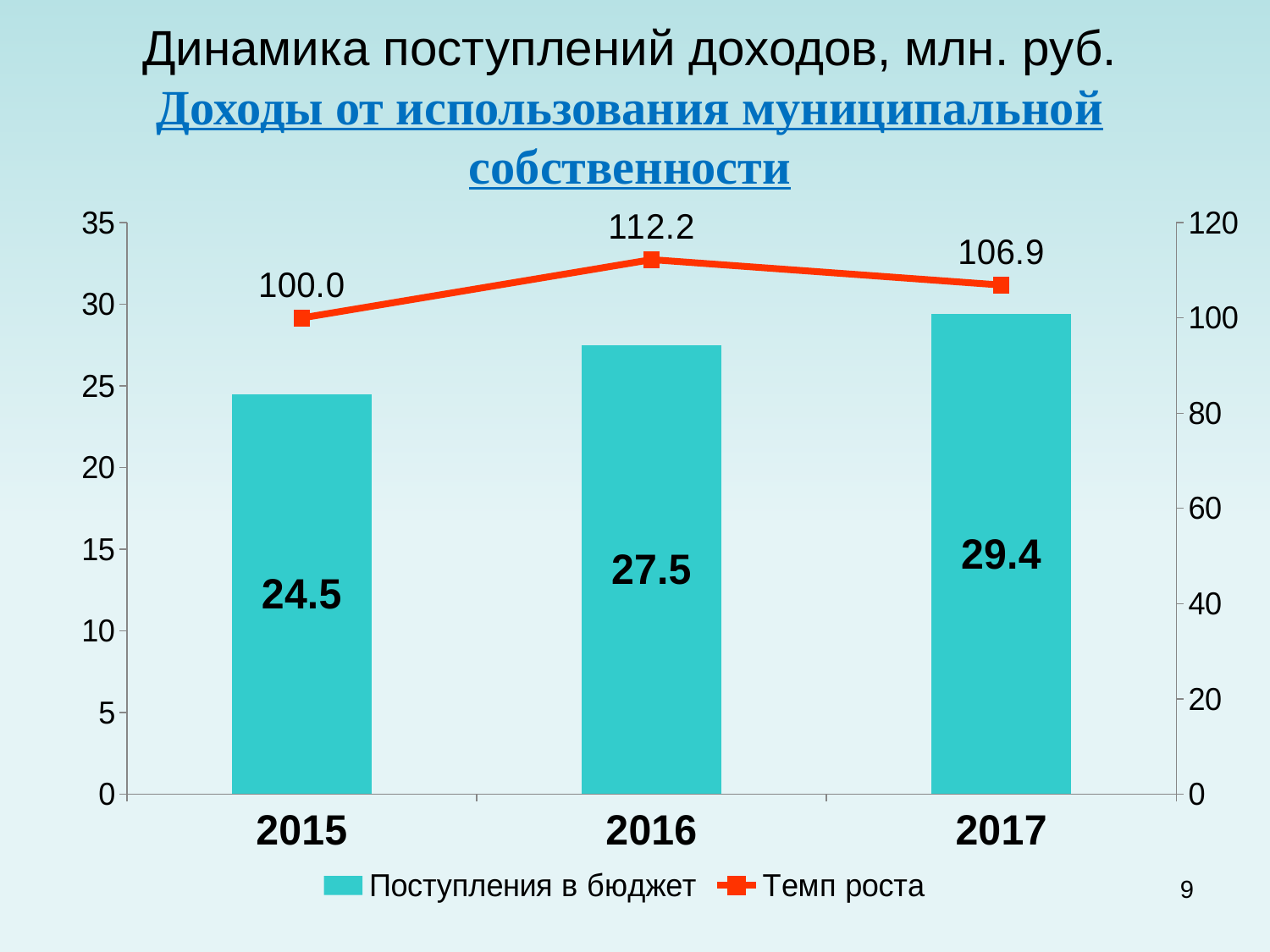
What is the value of Поступления в бюджет for 2015? 24.5 What is the value of Поступления в бюджет for 2016? 27.5 Do the values of Поступления в бюджет rise or fall from 2015 to 2017? rise What colour are the bars for Поступления в бюджет? Turquoise What is the difference between Поступления в бюджет in 2017 and 2015? 4.9 What is the value of Темп роста for 2017? 106.9 How many series does the legend list? 2 How many years are shown on the x axis? 3 Which year has the lowest value of Темп роста? 2015 Which is larger, Темп роста in 2016 or in 2017? 2016 Which year has the highest value of Поступления в бюджет? 2017 Is the value of Поступления в бюджет for 2017 greater or less than 25? greater